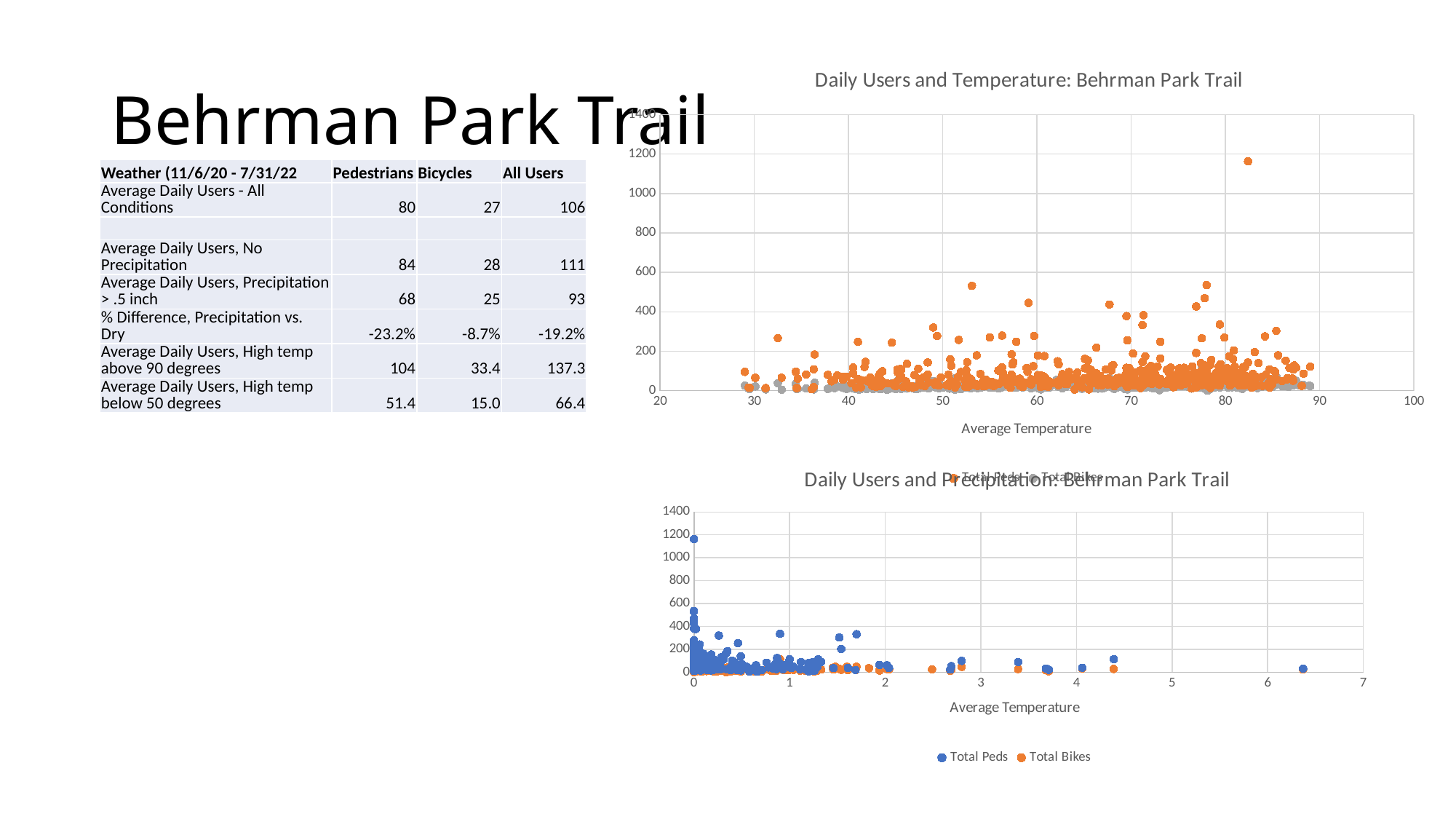
In the bottom chart, what is the maximum value shown on the y axis? 1400 In the top chart, is the highest plotted point greater or less than 1000? greater What kind of chart is the top chart titled "Daily Users and Temperature: Behrman Park Trail"? scatter chart In the top chart, is the highest plotted point greater or less than 1200? less What kind of chart is the bottom chart titled "Daily Users and Precipitation: Behrman Park Trail"? scatter chart In the bottom chart, how many series does the legend list? 2 In the bottom chart, which colour represents the Total Bikes series? orange In the bottom chart, is the highest Total Peds point greater or less than 1000? greater In the top chart, what is the maximum value shown on the x axis? 100 In the bottom chart, do the largest daily user values generally rise or fall as the x-axis value increases? fall